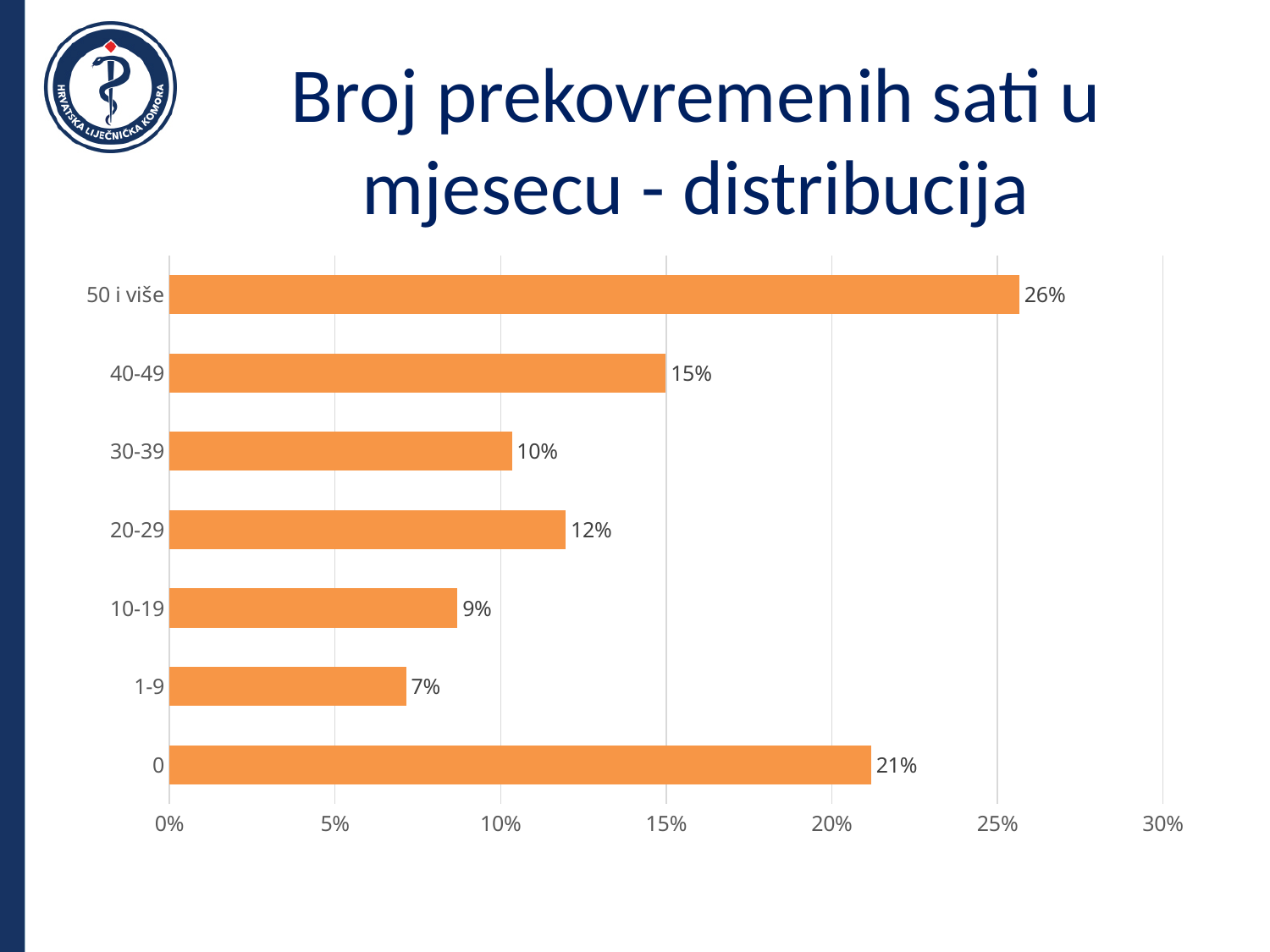
Which category has the lowest value? 1-9 What is the value for the "50 i više" category? 26% What is the title of the slide? Broj prekovremenih sati u mjesecu - distribucija What colour are the bars in the chart? Orange Is the value for "0" greater or less than 20%? greater How many categories are shown in the chart? 7 What is the difference between the values for "50 i više" and "40-49"? 11% What is the value for the "0" category? 21% Which is larger, the value for "20-29" or the value for "30-39"? 20-29 What is the value for the "20-29" category? 12% What kind of chart is shown on the slide? Bar chart Which category has the highest value? 50 i više